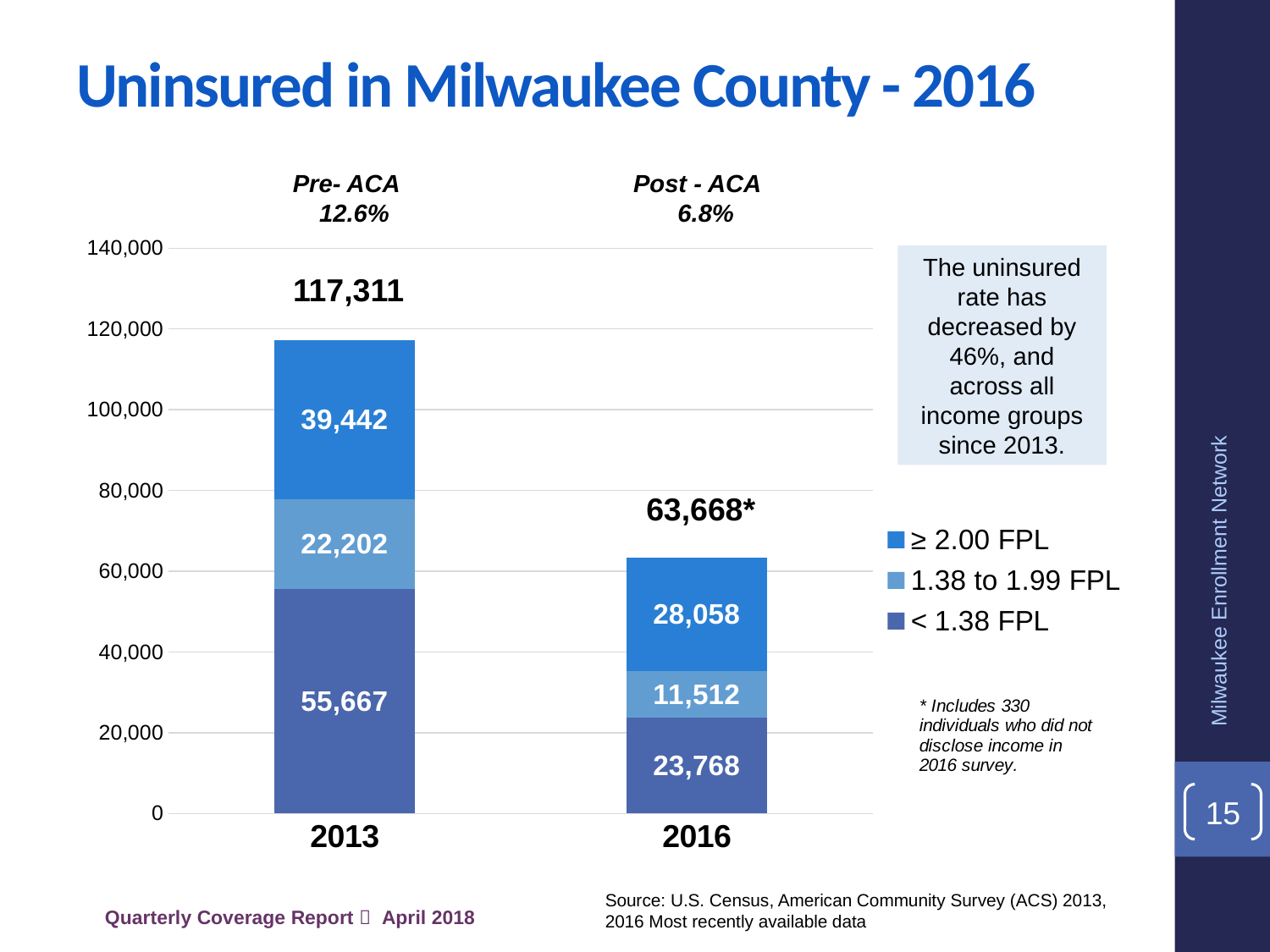
How many years (categories) are plotted on the x axis? 2 Is the total for 2016 greater or less than 80,000? less What is the value for 1.38 to 1.99 FPL in 2016? 11,512 What is the difference between the < 1.38 FPL values for 2013 and 2016? 31,899 Which year has the higher total number of uninsured? 2013 What kind of chart is shown on the slide? Stacked bar chart What is the total of the stacked bar for 2016? 63,668 What is the value for ≥ 2.00 FPL in 2013? 39,442 How many series does the legend list? 3 What is the value for < 1.38 FPL in 2013? 55,667 What is the total of the stacked bar for 2013? 117,311 Which is larger, the ≥ 2.00 FPL value in 2013 or in 2016? 2013